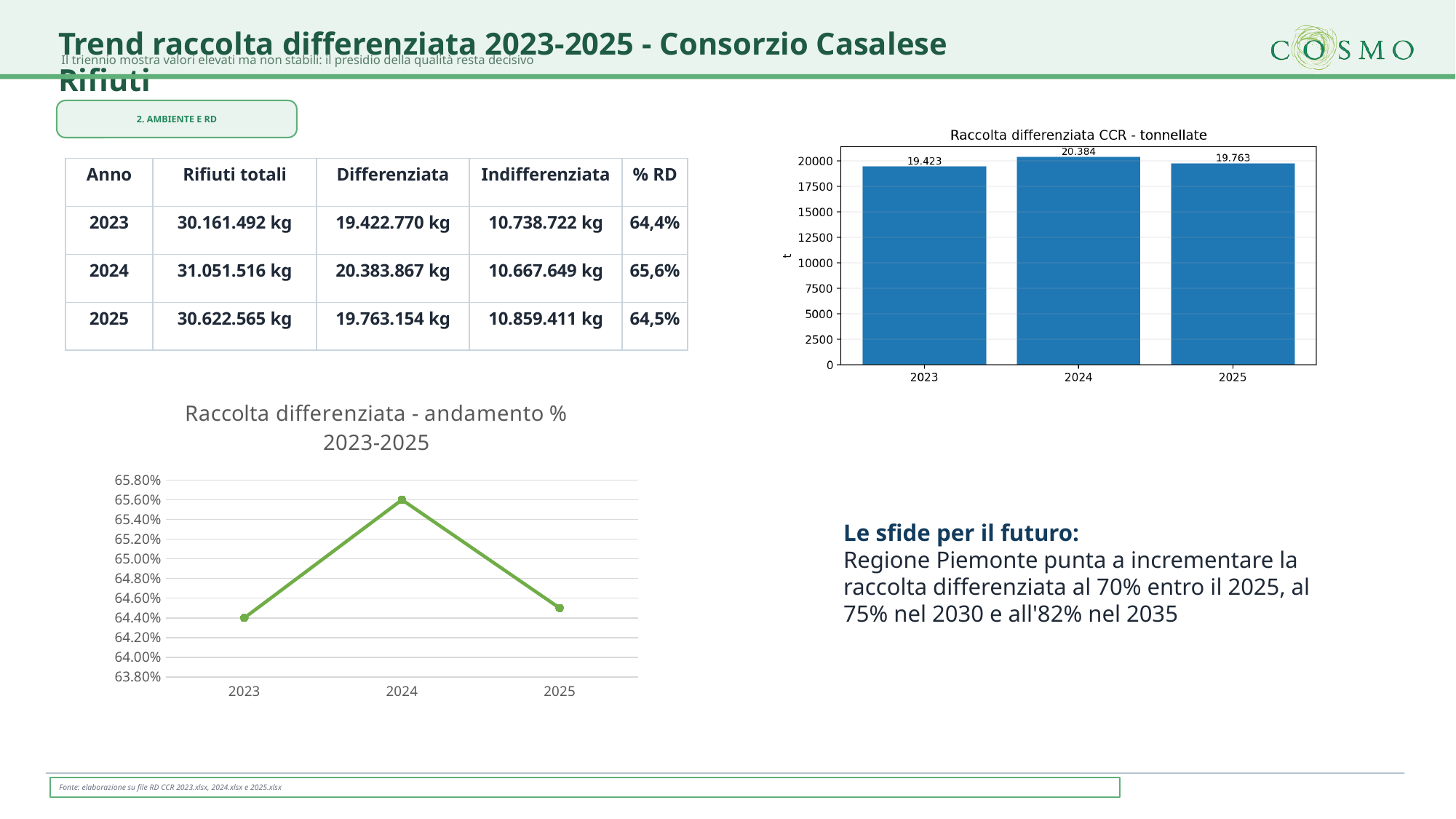
In the bar chart 'Raccolta differenziata CCR - tonnellate', what is the value for 2024? 20.384 What kind of chart is 'Raccolta differenziata CCR - tonnellate'? bar chart In the line chart 'Raccolta differenziata - andamento % 2023-2025', is the value for 2025 greater or less than 65.00%? less In the bar chart 'Raccolta differenziata CCR - tonnellate', what is the difference between the 2024 and 2025 values? 621 In the line chart 'Raccolta differenziata - andamento % 2023-2025', which year has the highest value? 2024 In the bar chart 'Raccolta differenziata CCR - tonnellate', how many bars are shown? 3 In the line chart 'Raccolta differenziata - andamento % 2023-2025', is the value for 2024 greater or less than 65.00%? greater In the bar chart 'Raccolta differenziata CCR - tonnellate', what is the value for 2023? 19.423 In the line chart 'Raccolta differenziata - andamento % 2023-2025', does the value rise or fall from 2024 to 2025? fall In the bar chart 'Raccolta differenziata CCR - tonnellate', which year has the highest value? 2024 In the bar chart 'Raccolta differenziata CCR - tonnellate', which year has the lowest value? 2023 What kind of chart is 'Raccolta differenziata - andamento % 2023-2025'? line chart